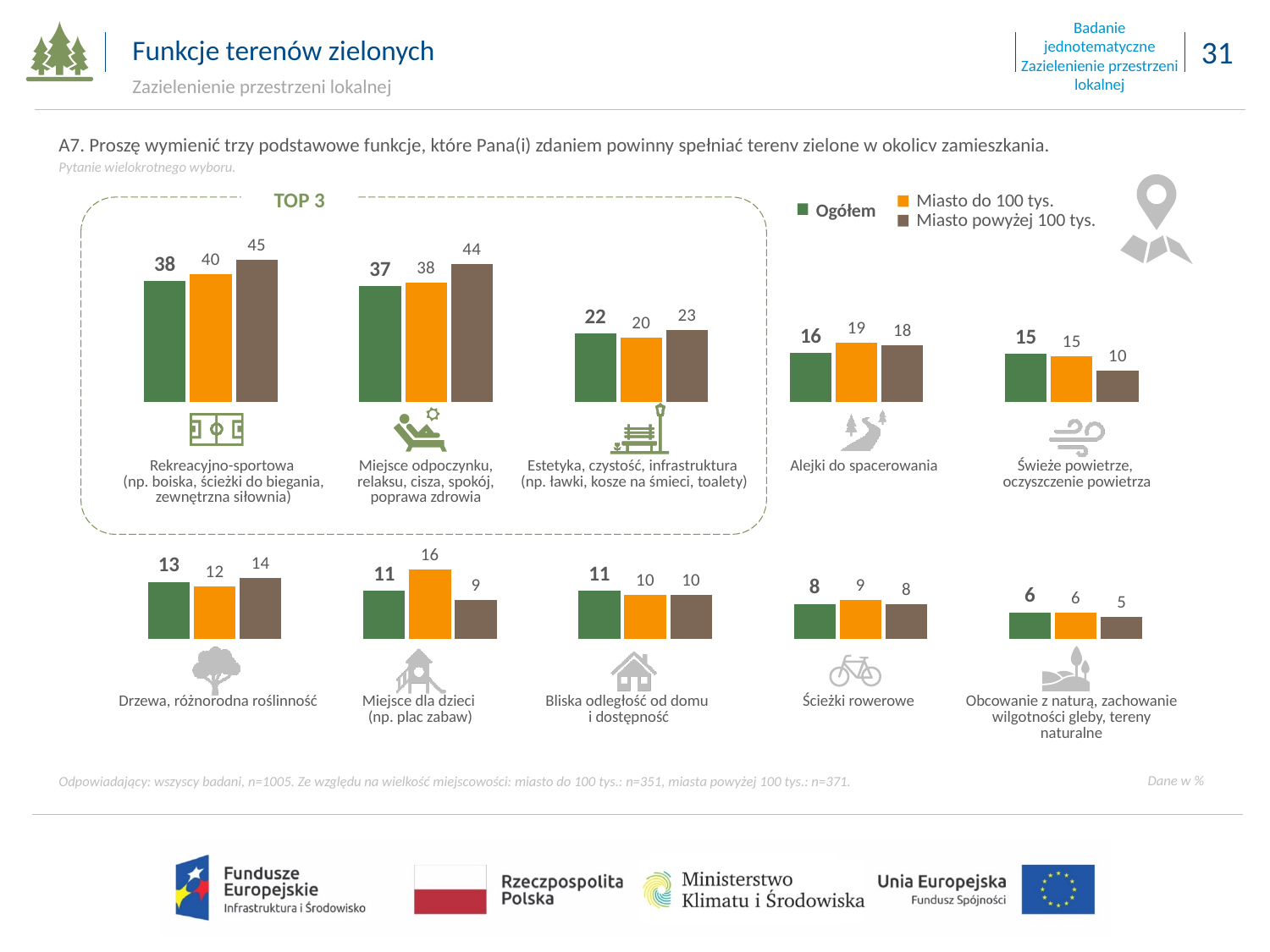
In the chart for "Rekreacyjno-sportowa", what is the difference between Miasto powyżej 100 tys. and Ogółem? 7 In the chart for "Miejsce dla dzieci (np. plac zabaw)", what is the value for Miasto do 100 tys.? 16 How many series does the legend list? 3 How many functions (categories) are shown on the slide? 10 Which colour represents the Ogółem series in the legend? Green Across all the charts on the slide, which function has the highest Ogółem value? Rekreacyjno-sportowa In the chart for "Rekreacyjno-sportowa", what is the value for Ogółem? 38 In the chart for "Świeże powietrze, oczyszczenie powietrza", what is the value for Miasto powyżej 100 tys.? 10 What kind of chart is used on the slide? Bar chart In the chart for "Miejsce odpoczynku, relaksu, cisza, spokój, poprawa zdrowia", what is the value for Miasto powyżej 100 tys.? 44 Across all the charts on the slide, which function has the lowest Ogółem value? Obcowanie z naturą, zachowanie wilgotności gleby, tereny naturalne In the chart for "Alejki do spacerowania", which is larger: Miasto do 100 tys. or Miasto powyżej 100 tys.? Miasto do 100 tys.